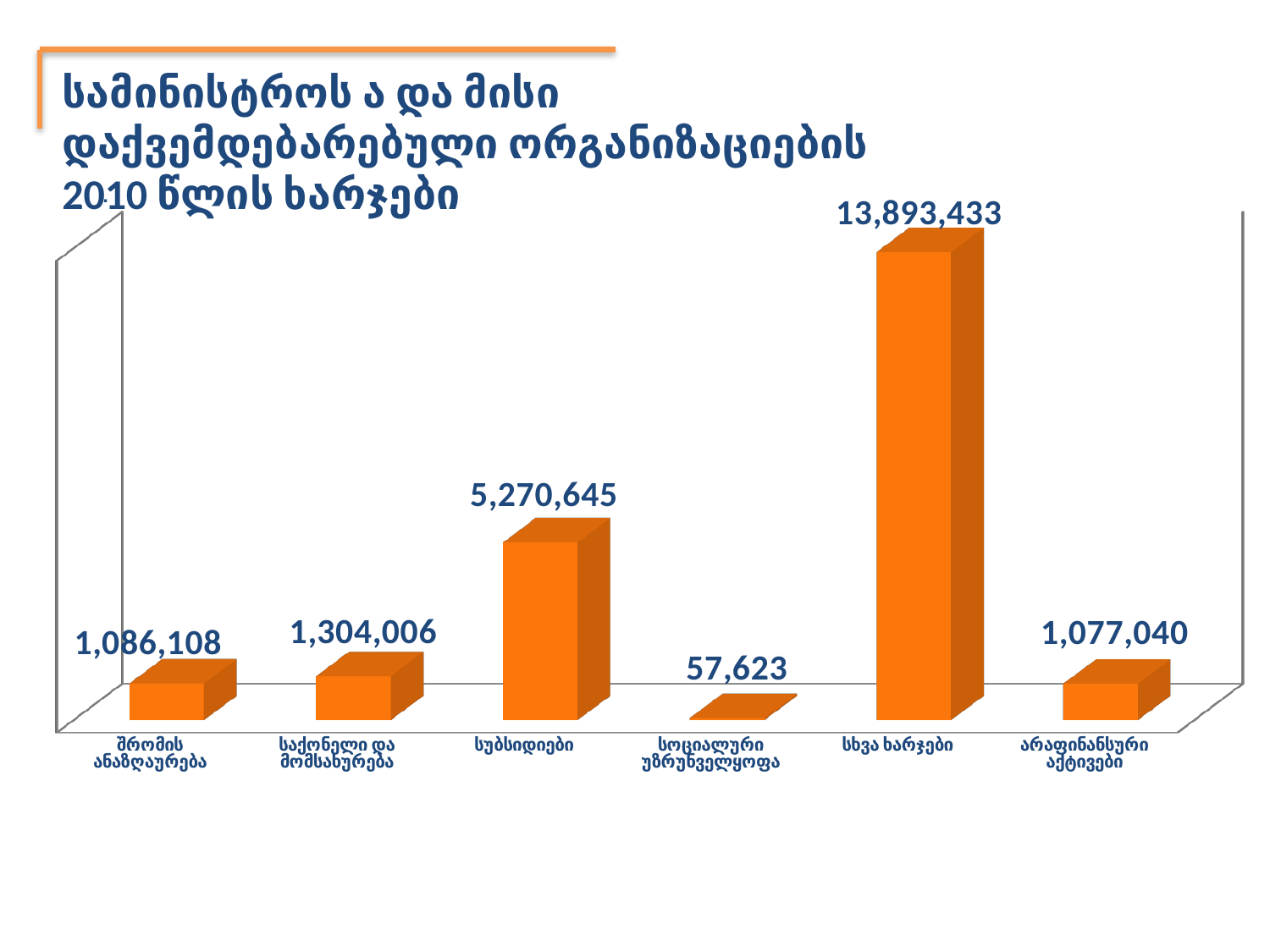
What kind of chart is shown on the slide? Bar chart How many categories are shown in the chart? 6 What is the value for არაფინანსური აქტივები? 1,077,040 Which is larger, სუბსიდიები or საქონელი და მომსახურება? სუბსიდიები What colour are the bars in the chart? Orange Which category has the highest value? სხვა ხარჯები What is the value for სუბსიდიები? 5,270,645 What is the value for სოციალური უზრუნველყოფა? 57,623 Which category has the lowest value? სოციალური უზრუნველყოფა What is the difference between სხვა ხარჯები and სუბსიდიები? 8,622,788 What is the difference between საქონელი და მომსახურება and შრომის ანაზღაურება? 217,898 What is the value for შრომის ანაზღაურება? 1,086,108